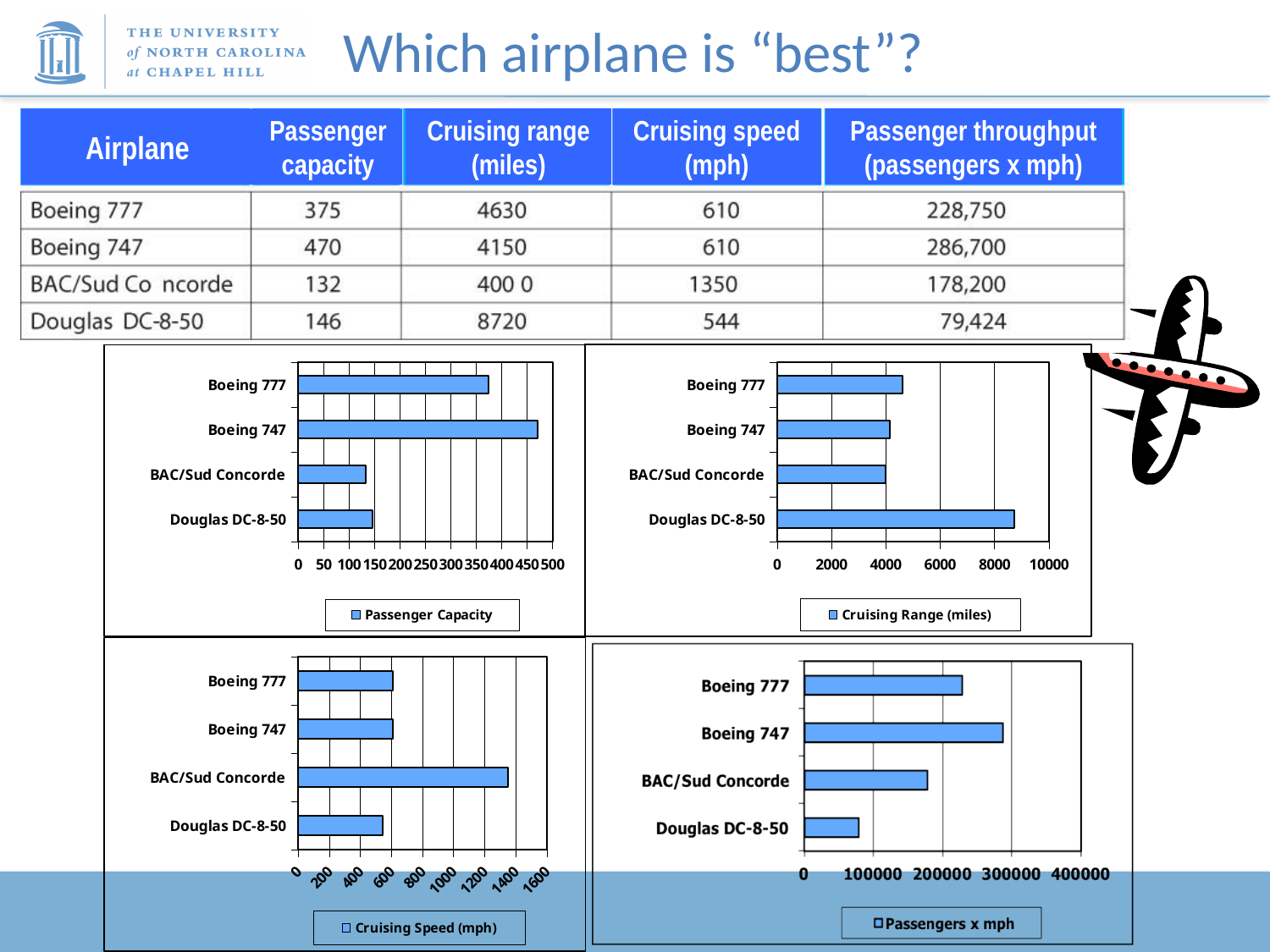
In the Cruising Speed (mph) chart, which airplane has the lowest cruising speed? Douglas DC-8-50 In the Passengers x mph chart, which airplane has the highest value? Boeing 747 How many airplanes are plotted in the Passenger Capacity chart? 4 In the Passenger Capacity chart, which airplane has the highest passenger capacity? Boeing 747 In the Passenger Capacity chart, is the value for Boeing 777 greater or less than 350? greater In the Cruising Range (miles) chart, is the value for Douglas DC-8-50 greater or less than 8000? greater In the Passengers x mph chart, is the value for Douglas DC-8-50 greater or less than 100000? less In the Cruising Range (miles) chart, which has the larger value, Boeing 777 or Boeing 747? Boeing 777 In the Cruising Range (miles) chart, which airplane has the longest cruising range? Douglas DC-8-50 What kind of chart is the Passengers x mph chart? bar chart